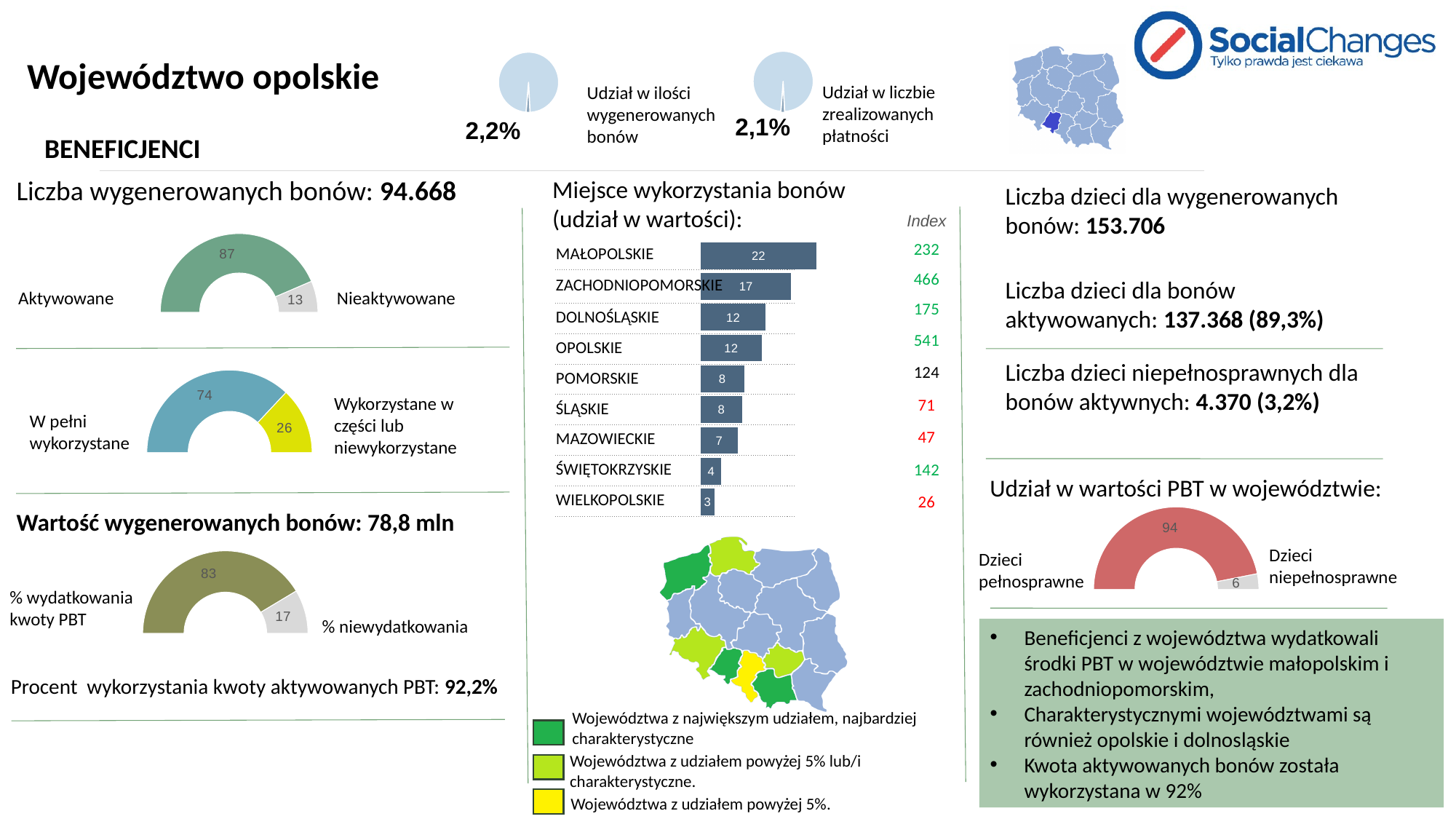
In the second half-donut chart on the left, what is the value for 'W pełni wykorzystane'? 74 In the bar chart 'Miejsce wykorzystania bonów (udział w wartości)', what is the value for MAŁOPOLSKIE? 22 In the half-donut chart under 'Liczba wygenerowanych bonów', what is the value for Aktywowane? 87 In the half-donut chart under 'Liczba wygenerowanych bonów', which is larger: Aktywowane or Nieaktywowane? Aktywowane In the half-donut chart 'Udział w wartości PBT w województwie', what is the value for 'Dzieci niepełnosprawne'? 6 In the half-donut chart under 'Wartość wygenerowanych bonów', what is the value for '% niewydatkowania'? 17 In the bar chart 'Miejsce wykorzystania bonów (udział w wartości)', which voivodeship has the lowest value? WIELKOPOLSKIE In the bar chart 'Miejsce wykorzystania bonów (udział w wartości)', what is the difference between the values for MAŁOPOLSKIE and ZACHODNIOPOMORSKIE? 5 How many voivodeships are listed in the bar chart 'Miejsce wykorzystania bonów (udział w wartości)'? 9 In the bar chart 'Miejsce wykorzystania bonów (udział w wartości)', what is the Index value shown for OPOLSKIE? 541 What kind of chart is 'Miejsce wykorzystania bonów (udział w wartości)'? bar chart In the bar chart 'Miejsce wykorzystania bonów (udział w wartości)', which voivodeship has the highest value? MAŁOPOLSKIE